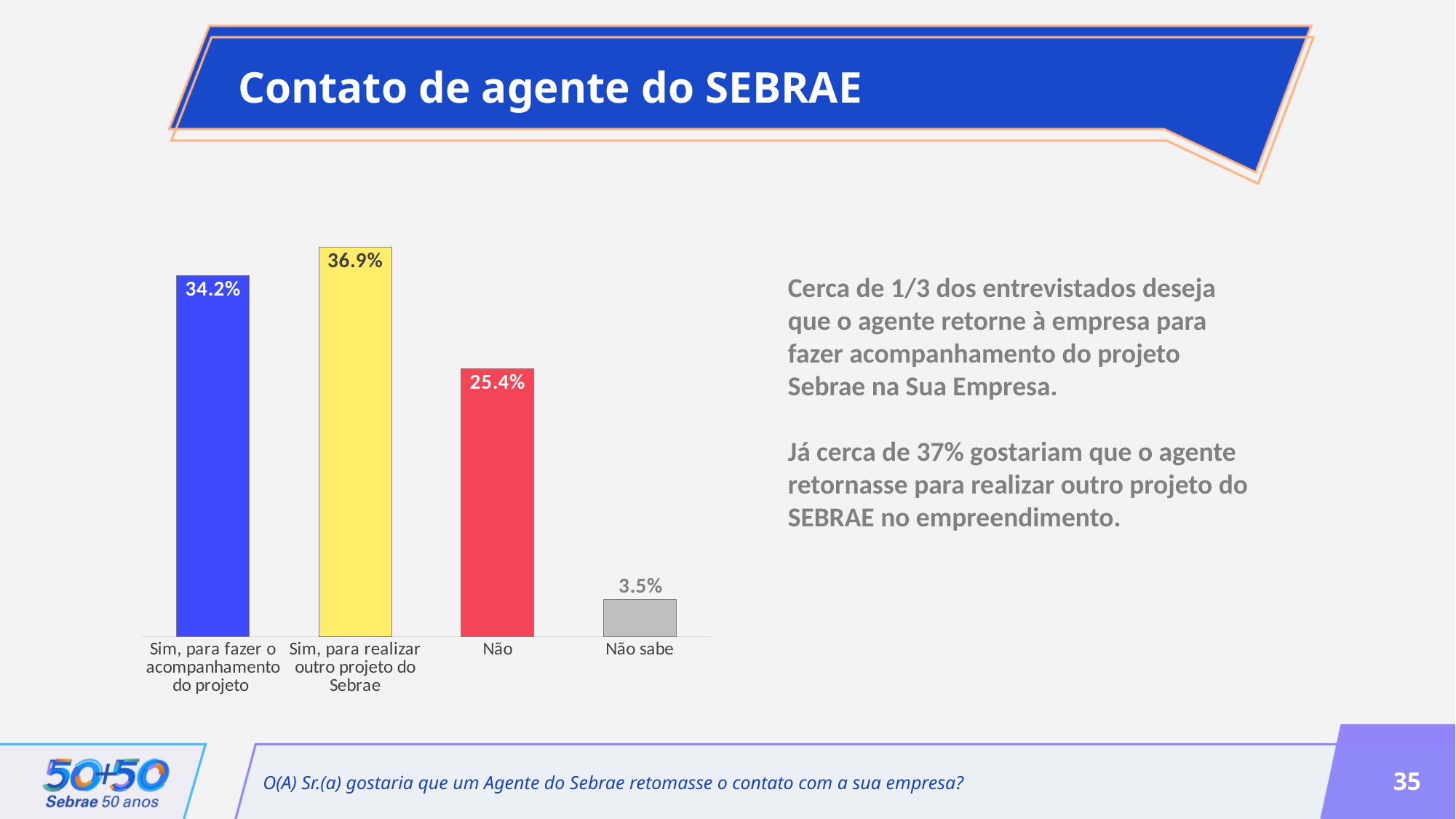
What is the difference between the values for "Sim, para realizar outro projeto do Sebrae" and "Sim, para fazer o acompanhamento do projeto"? 2.7% What kind of chart is shown on the slide? Bar chart What colour is the bar for "Não"? Red What is the value for "Não"? 25.4% How many categories are shown in the chart? 4 Which is larger, the value for "Não" or the value for "Sim, para fazer o acompanhamento do projeto"? Sim, para fazer o acompanhamento do projeto Which category has the lowest value? Não sabe What is the value for "Sim, para realizar outro projeto do Sebrae"? 36.9% What is the value for "Sim, para fazer o acompanhamento do projeto"? 34.2% What is the difference between the values for "Não" and "Não sabe"? 21.9% What is the value for "Não sabe"? 3.5% Which category has the highest value? Sim, para realizar outro projeto do Sebrae